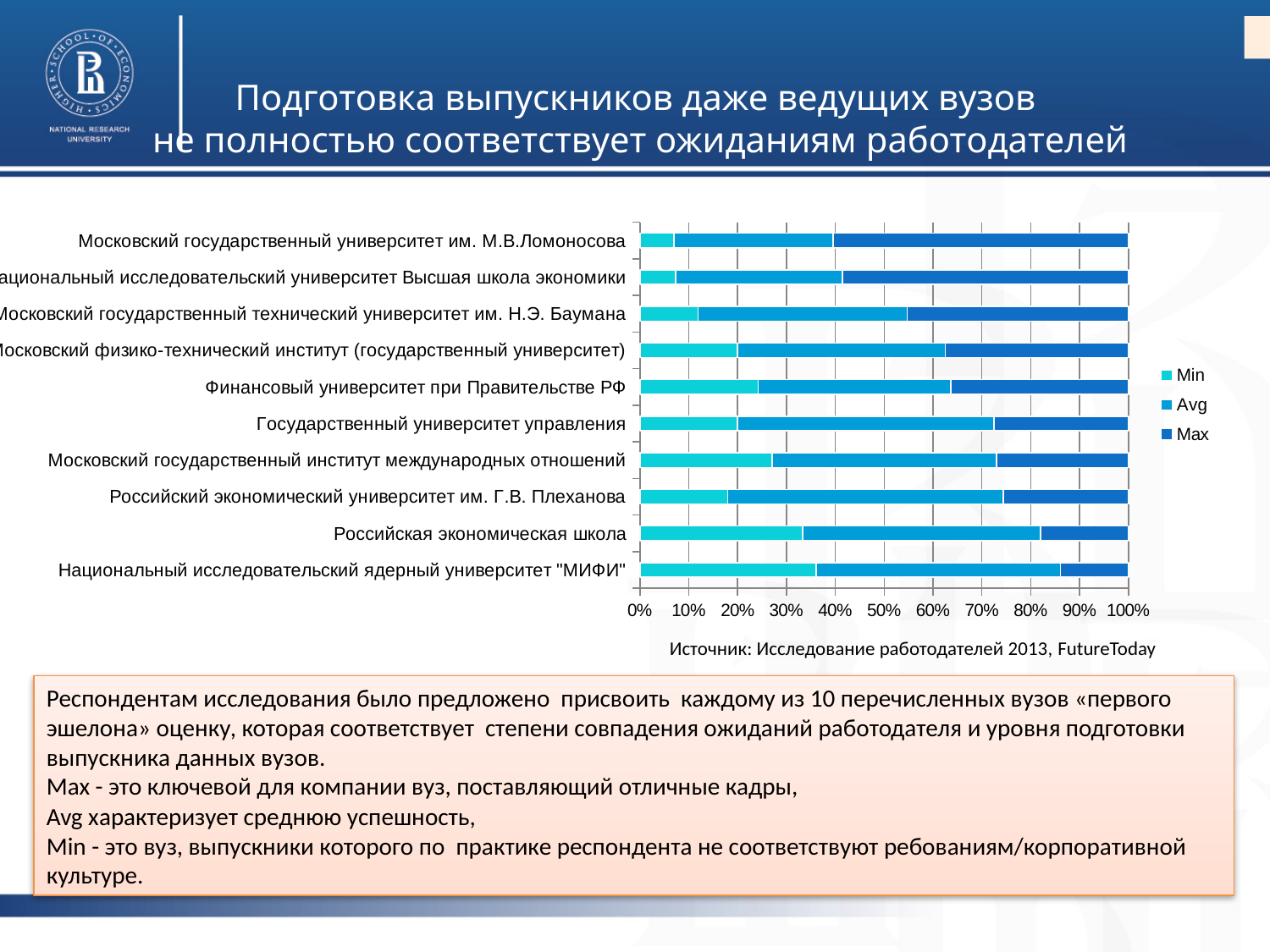
Is the Max share for Национальный исследовательский ядерный университет "МИФИ" greater or less than 20%? less Is the Min share for Московский государственный университет им. М.В.Ломоносова greater or less than 10%? less How many series does the legend list? 3 Which has the larger Min share: Национальный исследовательский ядерный университет "МИФИ" or Московский государственный университет им. М.В.Ломоносова? Национальный исследовательский ядерный университет "МИФИ" Is the Max share for Московский государственный университет им. М.В.Ломоносова greater or less than 50%? greater Going down the list of universities from top to bottom, does the Max share rise or fall? falls What are the series names shown in the legend? Min, Avg, Max What kind of chart is shown on the slide? Stacked bar chart Which university is listed first (at the top) of the chart? Московский государственный университет им. М.В.Ломоносова How many universities are listed on the chart? 10 Which university has the smallest Max share? Национальный исследовательский ядерный университет "МИФИ"